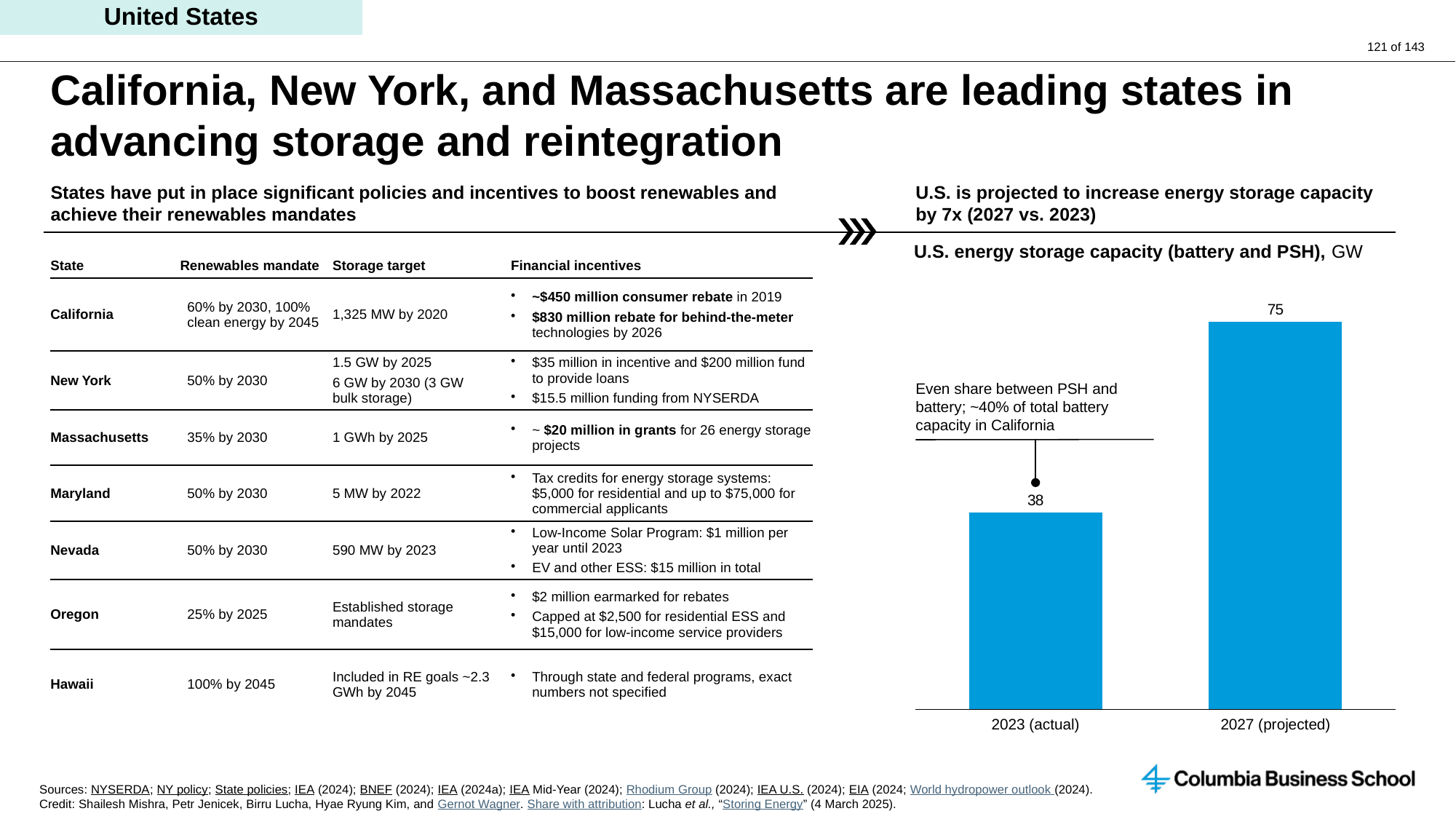
Is the value for 2027 (projected) larger or smaller than the value for 2023 (actual)? larger How many bars are plotted in the U.S. energy storage capacity chart? 2 Do the values in the chart rise or fall from 2023 (actual) to 2027 (projected)? rise What is the difference between the 2027 (projected) and 2023 (actual) values in the chart? 37 What is the U.S. energy storage capacity shown for 2023 (actual)? 38 Which category has the higher value in the U.S. energy storage capacity chart? 2027 (projected) What is the U.S. energy storage capacity shown for 2027 (projected)? 75 What is the title of the chart on the right side of the slide? U.S. energy storage capacity (battery and PSH), GW What unit is the U.S. energy storage capacity chart measured in? GW Which category has the lower value in the U.S. energy storage capacity chart? 2023 (actual) What kind of chart is used to show U.S. energy storage capacity? bar chart